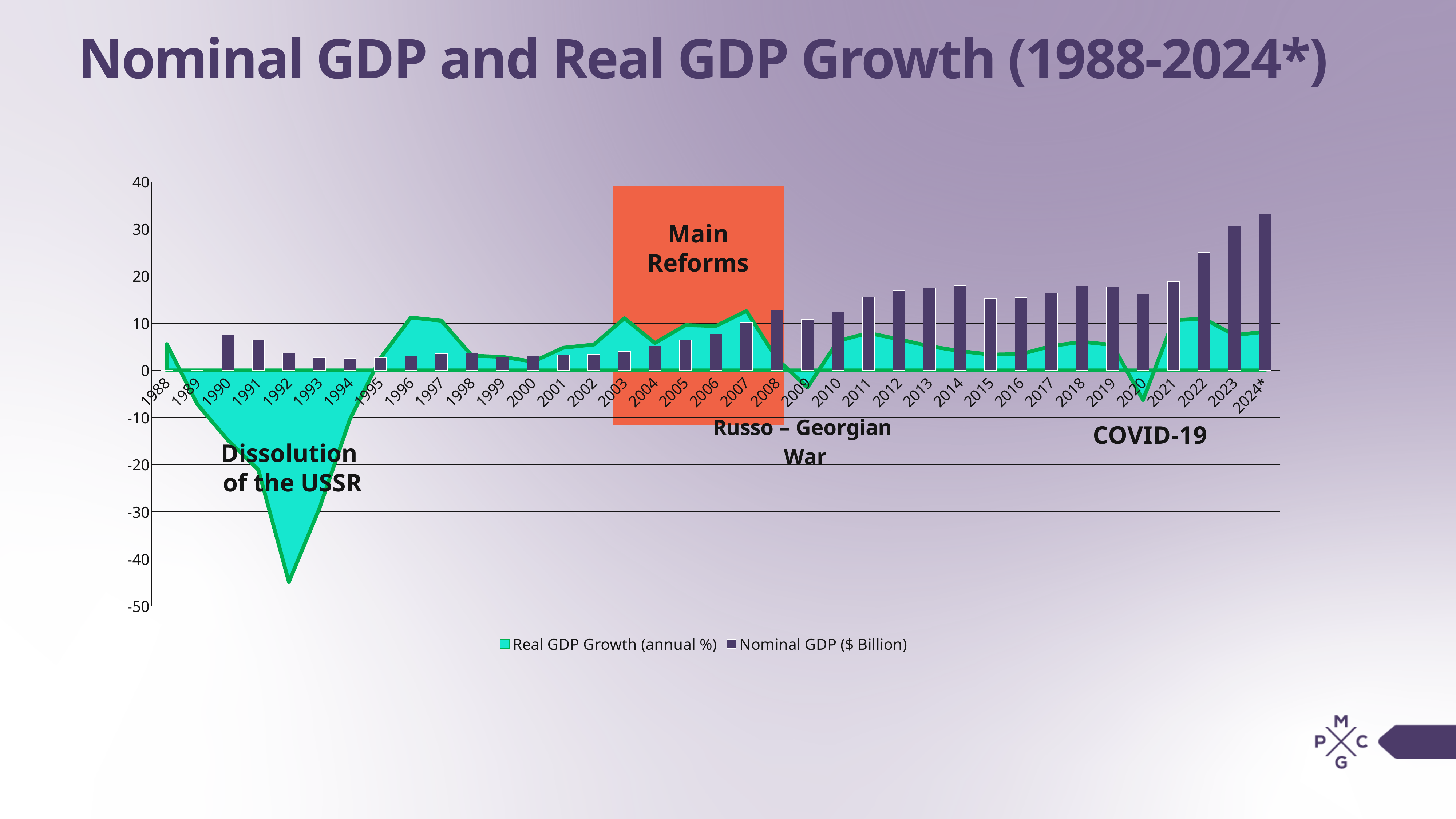
Which year has the larger Nominal GDP ($ Billion), 2021 or 2024*? 2024* Is the Real GDP Growth (annual %) value for 1992 greater or less than -40? less In which year is Real GDP Growth (annual %) lowest? 1992 What are the two series named in the legend? Real GDP Growth (annual %) and Nominal GDP ($ Billion) In which year is Nominal GDP ($ Billion) highest? 2024* Which years does the shaded 'Main Reforms' box cover? 2003 to 2008 How many series does the legend list? 2 Is the Nominal GDP ($ Billion) value for 1990 greater or less than 10? less How many years are shown on the x axis? 37 Is the Nominal GDP ($ Billion) value for 2024* greater or less than 30? greater What kind of chart is shown on the slide? A combination chart with an area series and a bar series Does Nominal GDP ($ Billion) rise or fall from 2021 to 2024*? rise